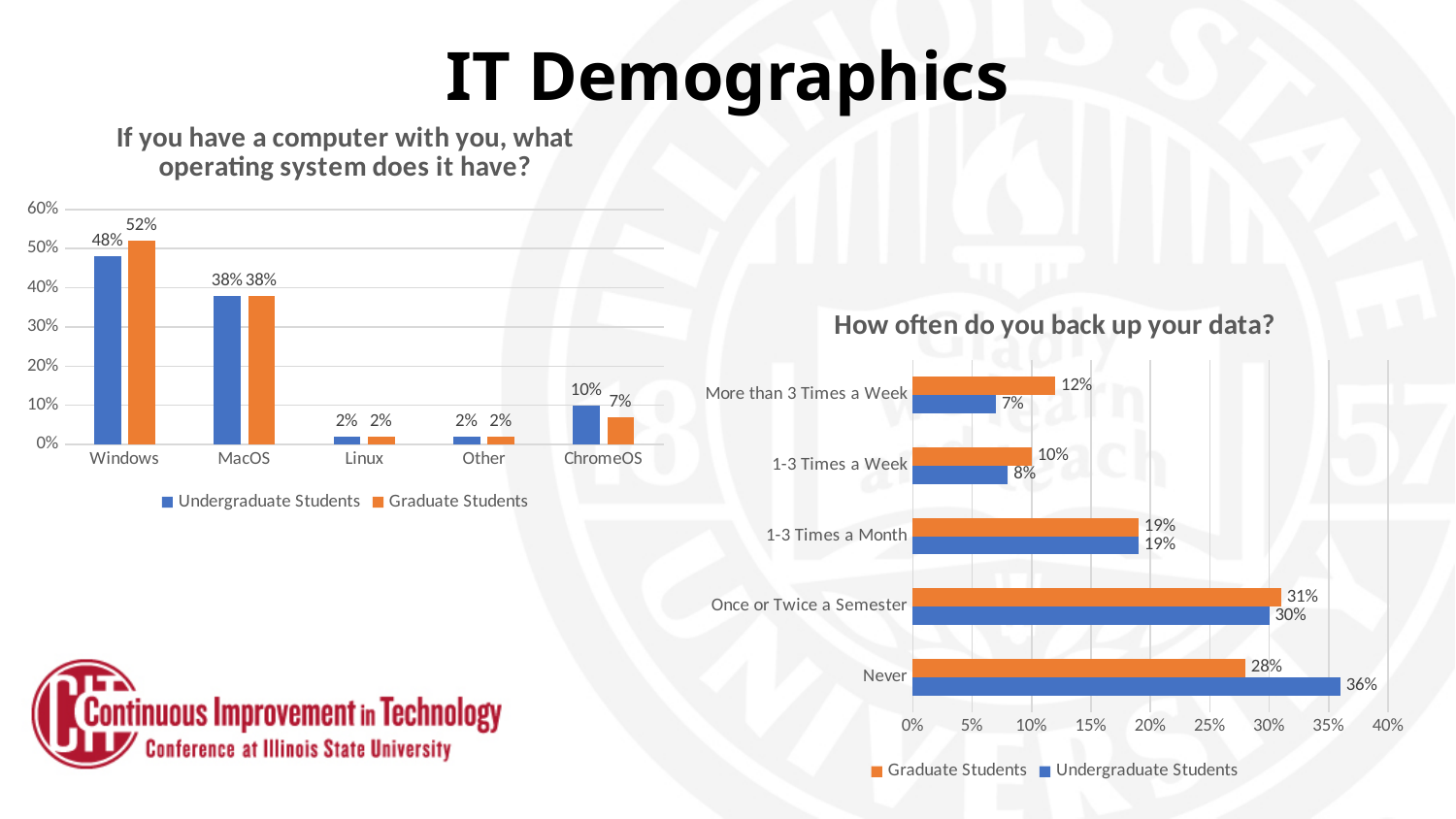
In the chart titled "If you have a computer with you, what operating system does it have?", which operating system has the highest value for Undergraduate Students? Windows In the chart titled "If you have a computer with you, what operating system does it have?", how many operating system categories are shown? 5 In the chart titled "If you have a computer with you, what operating system does it have?", what is the value for Undergraduate Students for ChromeOS? 10% In the chart titled "How often do you back up your data?", what is the difference between Undergraduate Students and Graduate Students for Never? 8% In the chart titled "How often do you back up your data?", how many series does the legend list? 2 In the chart titled "If you have a computer with you, what operating system does it have?", what type of chart is used? Bar chart In the chart titled "If you have a computer with you, what operating system does it have?", what is the value for Graduate Students for Windows? 52% In the chart titled "How often do you back up your data?", which is larger for Never: Graduate Students or Undergraduate Students? Undergraduate Students In the chart titled "How often do you back up your data?", which category has the highest value for Graduate Students? Once or Twice a Semester In the chart titled "How often do you back up your data?", what is the value for Graduate Students for More than 3 Times a Week? 12% In the chart titled "If you have a computer with you, what operating system does it have?", what is the difference between the Graduate Students and Undergraduate Students values for Windows? 4% In the chart titled "How often do you back up your data?", what is the value for Undergraduate Students for Never? 36%